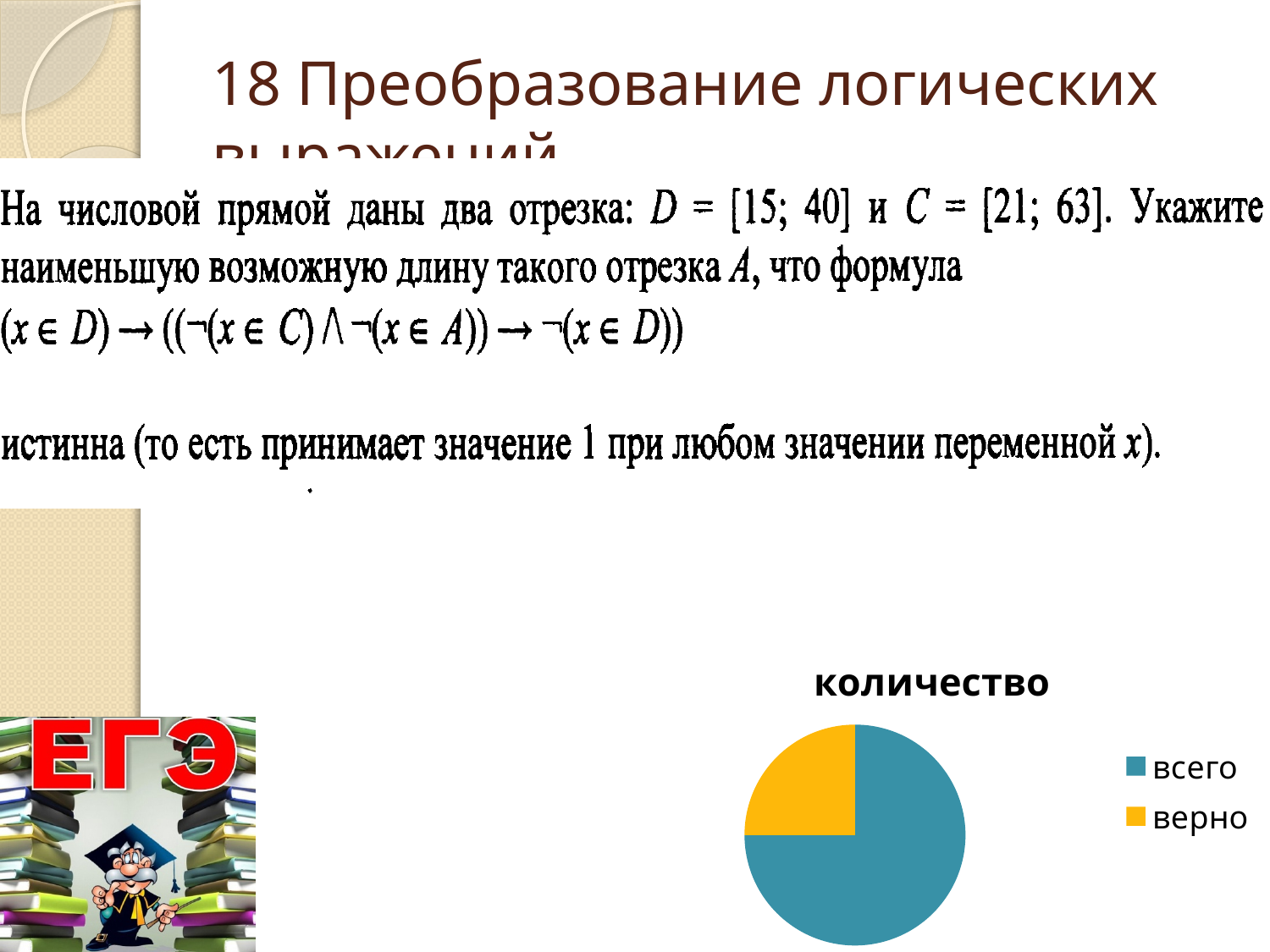
What is the title of the pie chart? количество Which is larger in the pie chart, всего or верно? всего What colour is the slice for верно in the pie chart? yellow How many entries does the legend of the pie chart list? 2 What kind of chart is shown on the slide? pie chart Which slice of the pie chart is the largest? всего How many slices does the pie chart have? 2 Which slice of the pie chart is the smallest? верно